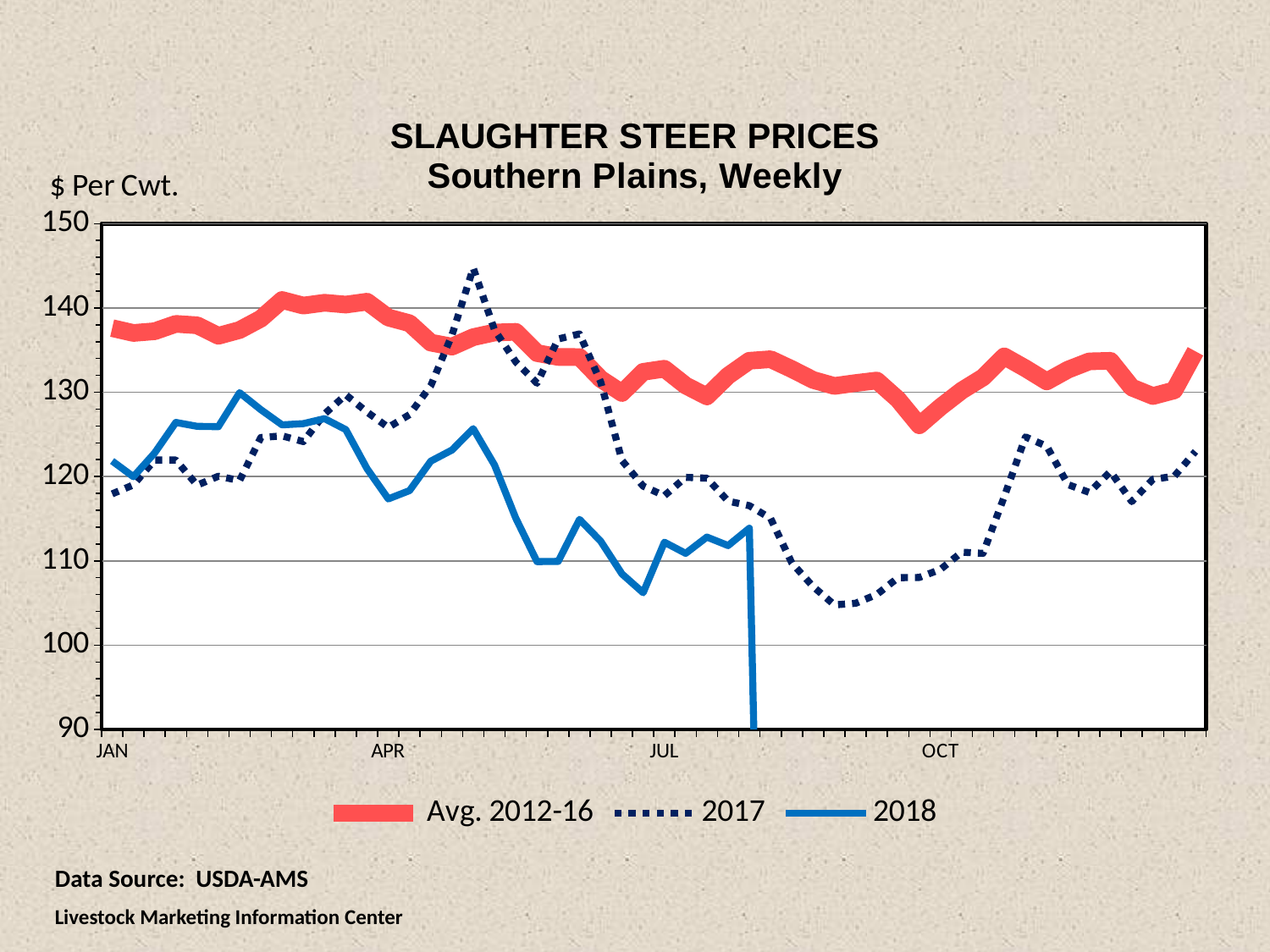
What is the title of the chart? SLAUGHTER STEER PRICES Southern Plains, Weekly Is the value of the 2018 series at APR greater or less than 120? less Is the peak value of the 2017 series greater or less than 140? greater At JAN, which series is higher, Avg. 2012-16 or 2018? Avg. 2012-16 Does the 2018 series rise or fall between APR and JUL? fall At JUL, which series is higher, 2017 or 2018? 2017 What unit is shown on the y axis label? $ Per Cwt. What kind of chart is shown on the slide? line chart Is the lowest value of the 2017 series greater or less than 110? less How many series does the legend list? 3